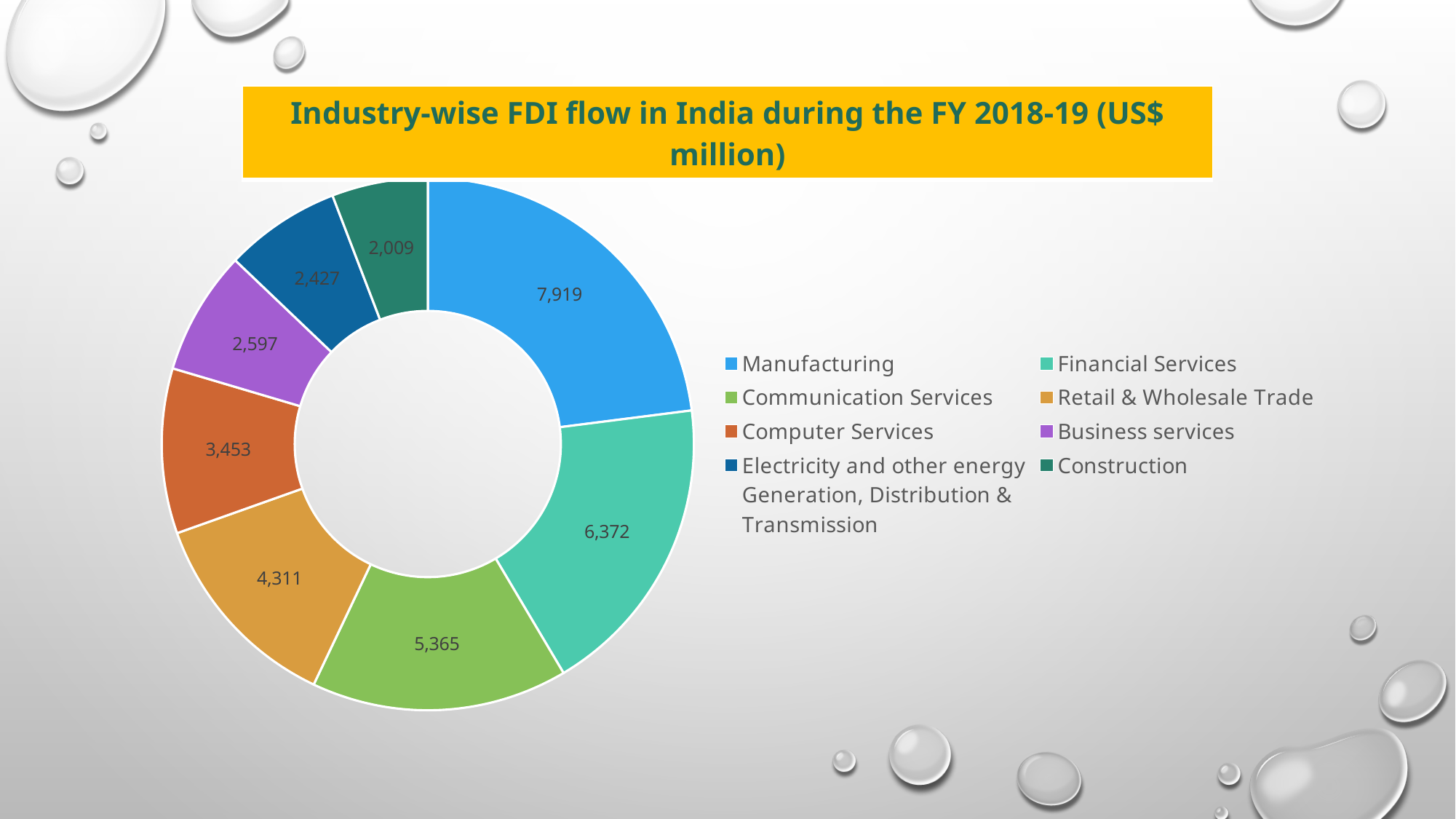
What kind of chart is shown on the slide? Doughnut chart What is the FDI flow value for Retail & Wholesale Trade? 4,311 What is the FDI flow value for Electricity and other energy Generation, Distribution & Transmission? 2,427 What is the difference between the FDI flow for Retail & Wholesale Trade and Computer Services? 858 Which is larger, the FDI flow for Communication Services or for Computer Services? Communication Services What is the FDI flow value for Manufacturing? 7,919 Which industry received the lowest FDI flow? Construction What is the difference between the FDI flow for Manufacturing and Financial Services? 1,547 How many industries are shown in the chart? 8 Which industry received the highest FDI flow? Manufacturing What is the title of the chart? Industry-wise FDI flow in India during the FY 2018-19 (US$ million) What is the total FDI flow across all industries shown? 34,453